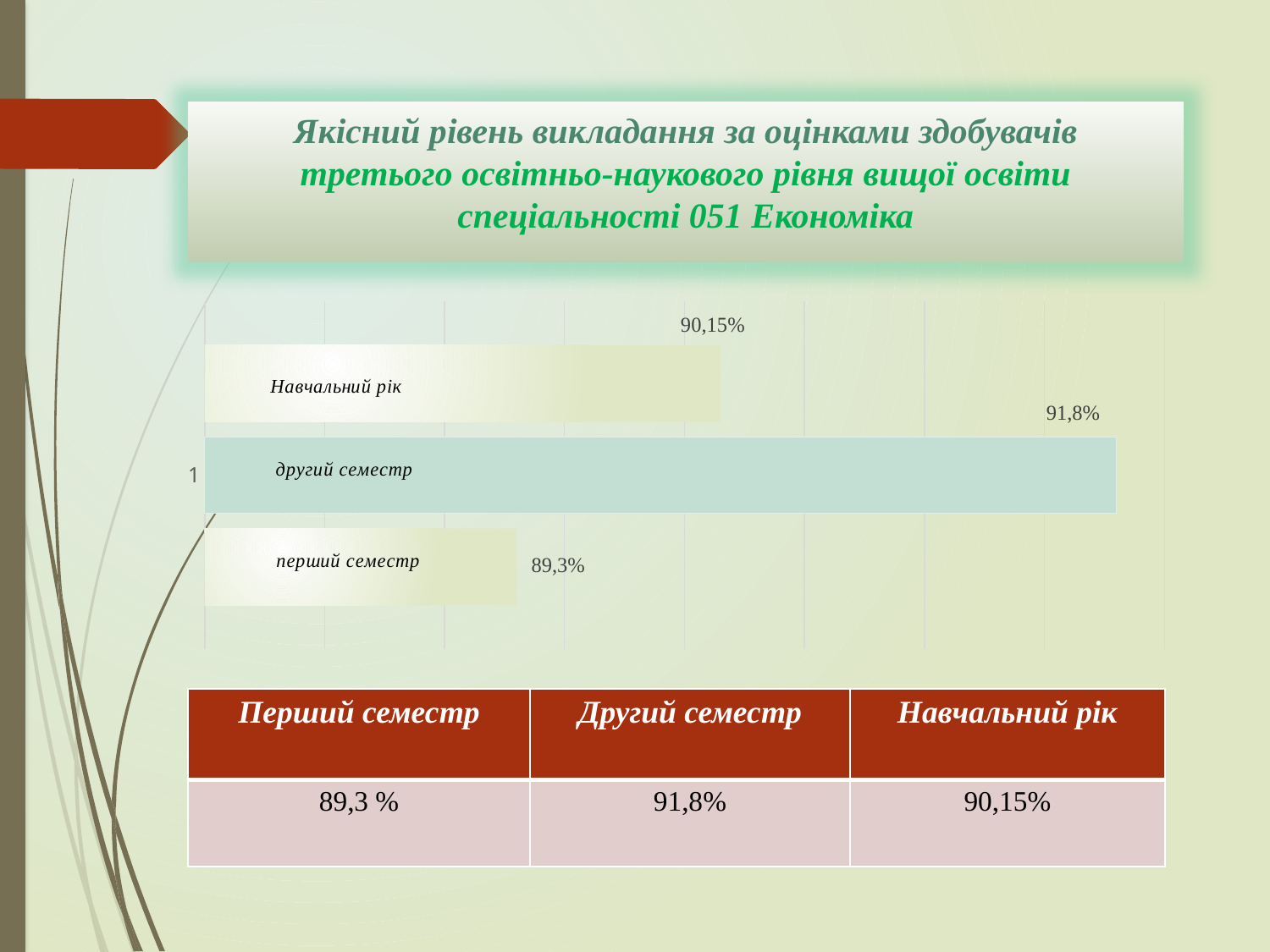
What is the value shown for Навчальний рік? 90,15% How many bars are plotted in the chart? 3 What is the difference between the values for другий семестр and Навчальний рік? 1,65% Which is larger, the value for Навчальний рік or the value for перший семестр? Навчальний рік Which specialty is named in the slide title? 051 Економіка Which bar has the lowest value? перший семестр What is the value shown for другий семестр? 91,8% What is the value shown for перший семестр? 89,3% What is the difference between the values for другий семестр and перший семестр? 2,5% What kind of chart is shown on the slide? bar chart What is the difference between the values for Навчальний рік and перший семестр? 0,85% Which bar has the highest value? другий семестр